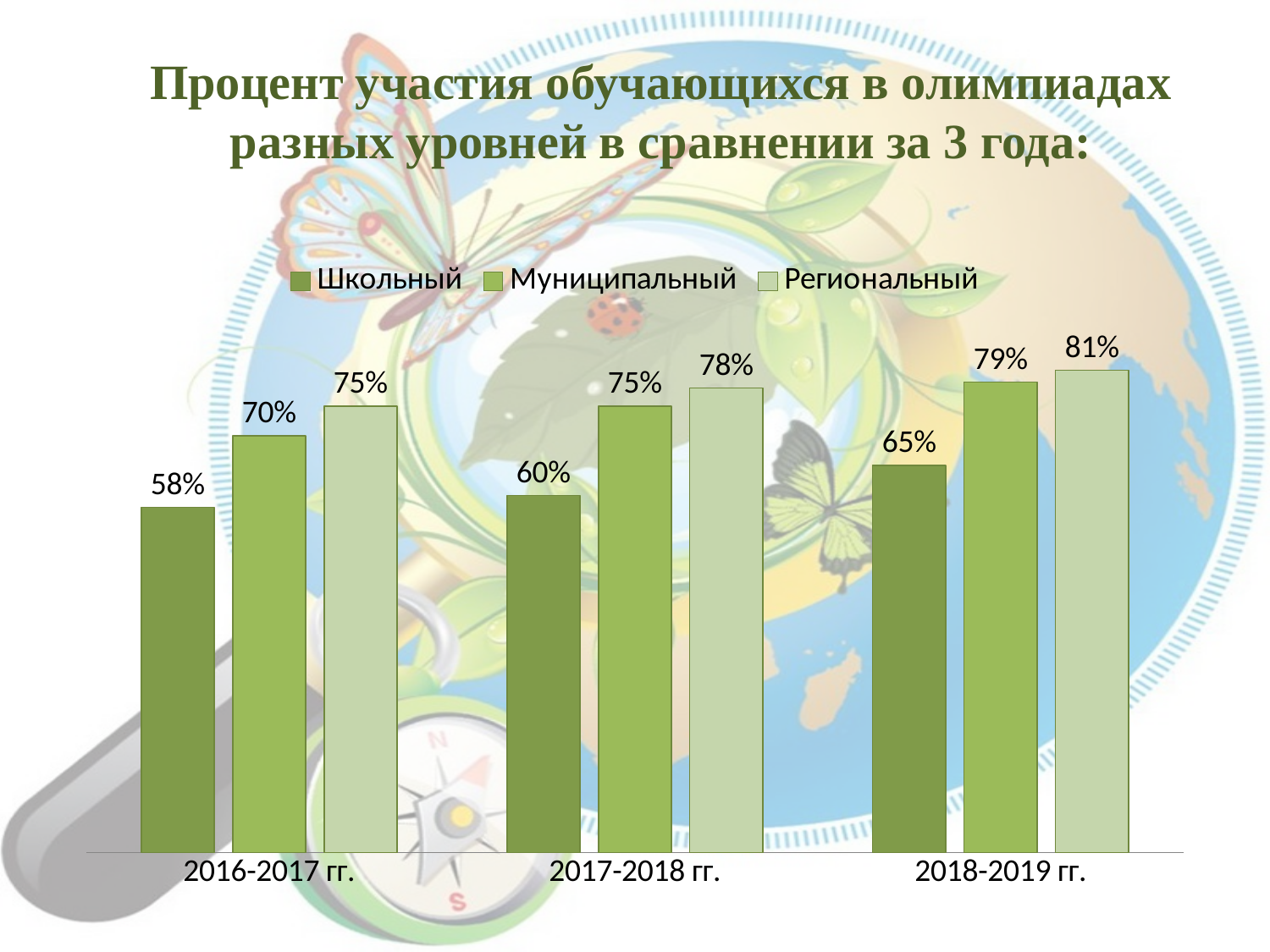
How many year categories are shown on the x axis? 3 What is the third series listed in the legend? Региональный Do the values for Муниципальный rise or fall from 2016-2017 гг. to 2018-2019 гг.? Rise What kind of chart is shown on the slide? Bar chart How many series does the legend list? 3 Which is larger in 2017-2018 гг.: Муниципальный or Региональный? Региональный Which year has the highest value for Школьный? 2018-2019 гг. What is the value for Муниципальный in 2017-2018 гг.? 75% What is the value for Школьный in 2016-2017 гг.? 58% What is the difference between Региональный and Школьный in 2018-2019 гг.? 16% Which year has the lowest value for Региональный? 2016-2017 гг. What is the value for Региональный in 2018-2019 гг.? 81%